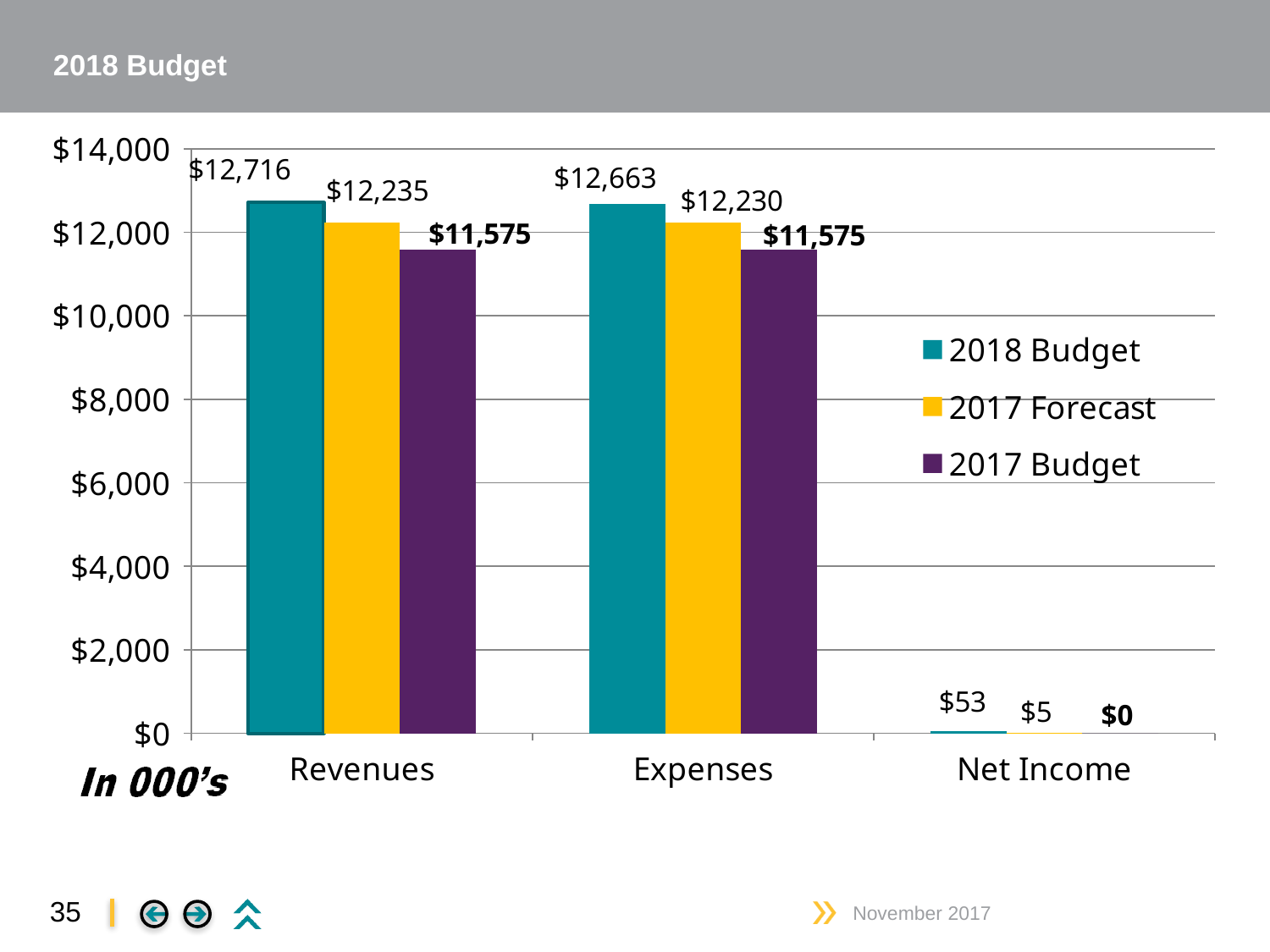
What is the 2017 Budget value for Net Income? $0 Which is larger for Expenses: the 2018 Budget value or the 2017 Forecast value? 2018 Budget Which category has the lowest 2018 Budget value? Net Income What is the 2017 Forecast value for Expenses? $12,230 How many categories are shown on the x axis? 3 What kind of chart is shown on the slide? bar chart What is the 2018 Budget value for Revenues? $12,716 What is the 2018 Budget value for Net Income? $53 What is the difference between the 2018 Budget and 2017 Budget values for Revenues? $1,141 What is the difference between the 2018 Budget values for Revenues and Expenses? $53 Is the 2017 Budget value for Expenses greater or less than $12,000? less How many series does the legend list? 3